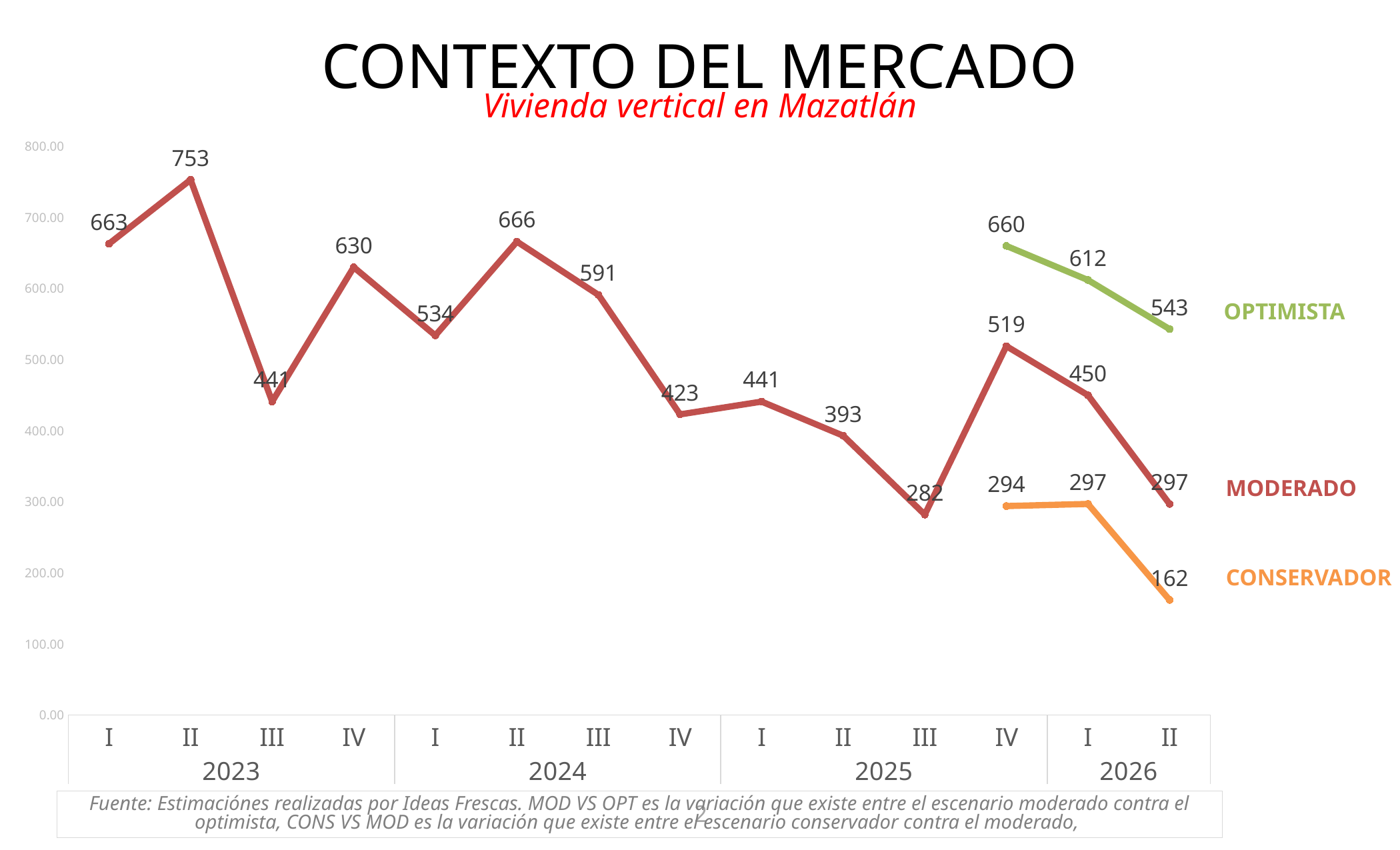
What is the OPTIMISTA value for quarter II of 2026? 543 How many series are labelled on the chart? 3 How many quarters are shown on the x axis? 14 Which is larger in quarter IV of 2025: the OPTIMISTA value or the MODERADO value? OPTIMISTA In which quarter does the MODERADO series reach its lowest value? III 2025 What is the CONSERVADOR value for quarter I of 2026? 297 In which quarter does the MODERADO series reach its highest value? II 2023 Does the CONSERVADOR series rise or fall from quarter I of 2026 to quarter II of 2026? fall What is the difference between the OPTIMISTA and MODERADO values in quarter II of 2026? 246 What is the MODERADO value for quarter II of 2023? 753 Is the MODERADO value for quarter I of 2024 greater or less than 500? greater What type of chart is shown on the slide? line chart